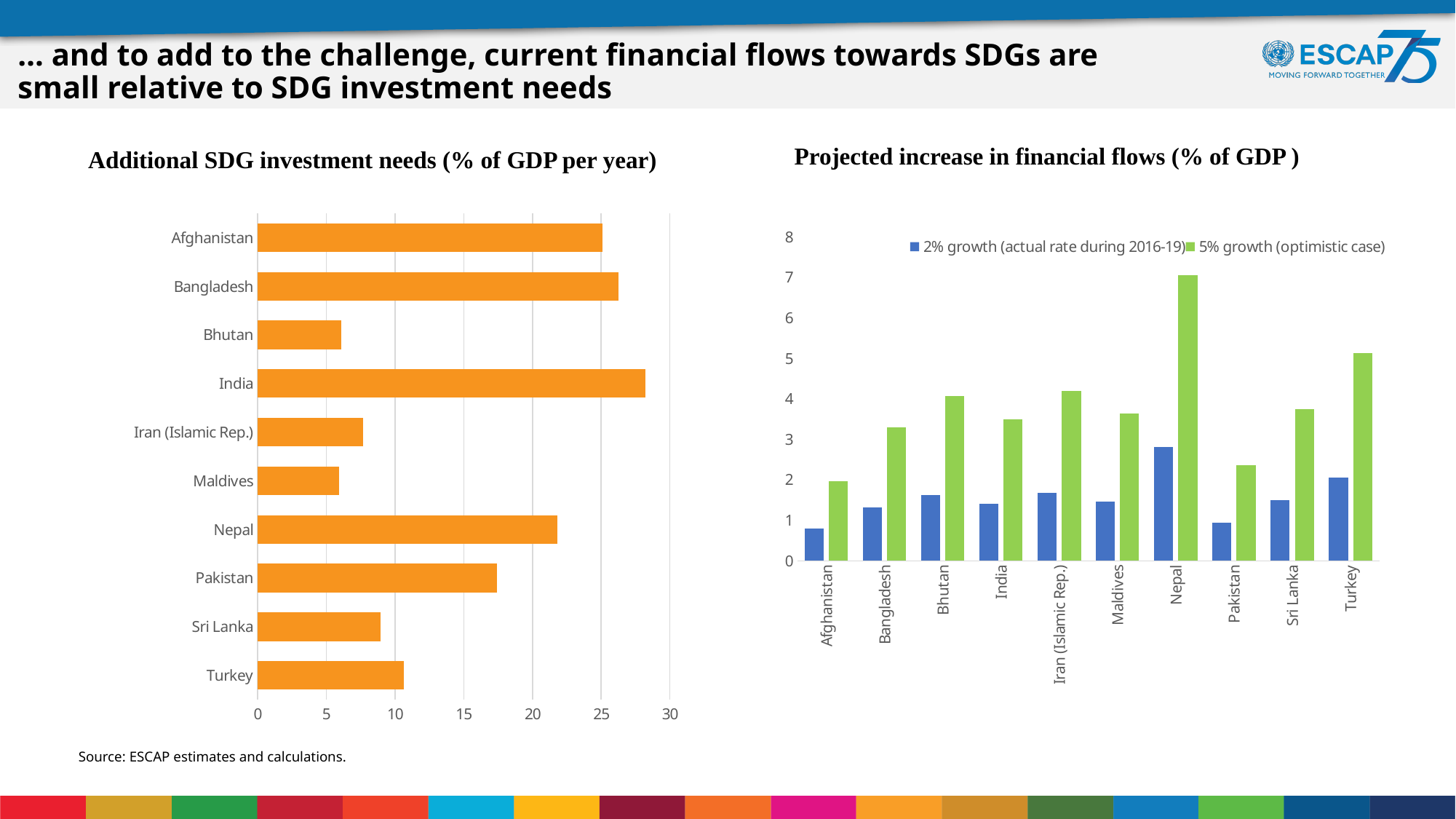
In the 'Additional SDG investment needs (% of GDP per year)' chart, which is larger, the value for Sri Lanka or the value for Pakistan? Pakistan In the 'Projected increase in financial flows (% of GDP)' chart, which country has the highest value for the 5% growth (optimistic case) series? Nepal In the 'Additional SDG investment needs (% of GDP per year)' chart, is the value for Pakistan greater or less than 20? less In the 'Additional SDG investment needs (% of GDP per year)' chart, which country has the highest value? India In the 'Projected increase in financial flows (% of GDP)' chart, which country has the lowest value for the 2% growth (actual rate during 2016-19) series? Afghanistan In the 'Additional SDG investment needs (% of GDP per year)' chart, is the value for Nepal greater or less than 20? greater In the 'Projected increase in financial flows (% of GDP)' chart, what colour are the bars for the 5% growth (optimistic case) series? Green In the 'Projected increase in financial flows (% of GDP)' chart, is the 5% growth value for Nepal greater or less than 6? greater How many series does the legend list in the 'Projected increase in financial flows (% of GDP)' chart? 2 In the 'Projected increase in financial flows (% of GDP)' chart, which is larger, the 5% growth value for Bhutan or the 5% growth value for India? Bhutan What kind of chart is the 'Additional SDG investment needs (% of GDP per year)' chart? Bar chart How many countries are shown in the 'Additional SDG investment needs (% of GDP per year)' chart? 10